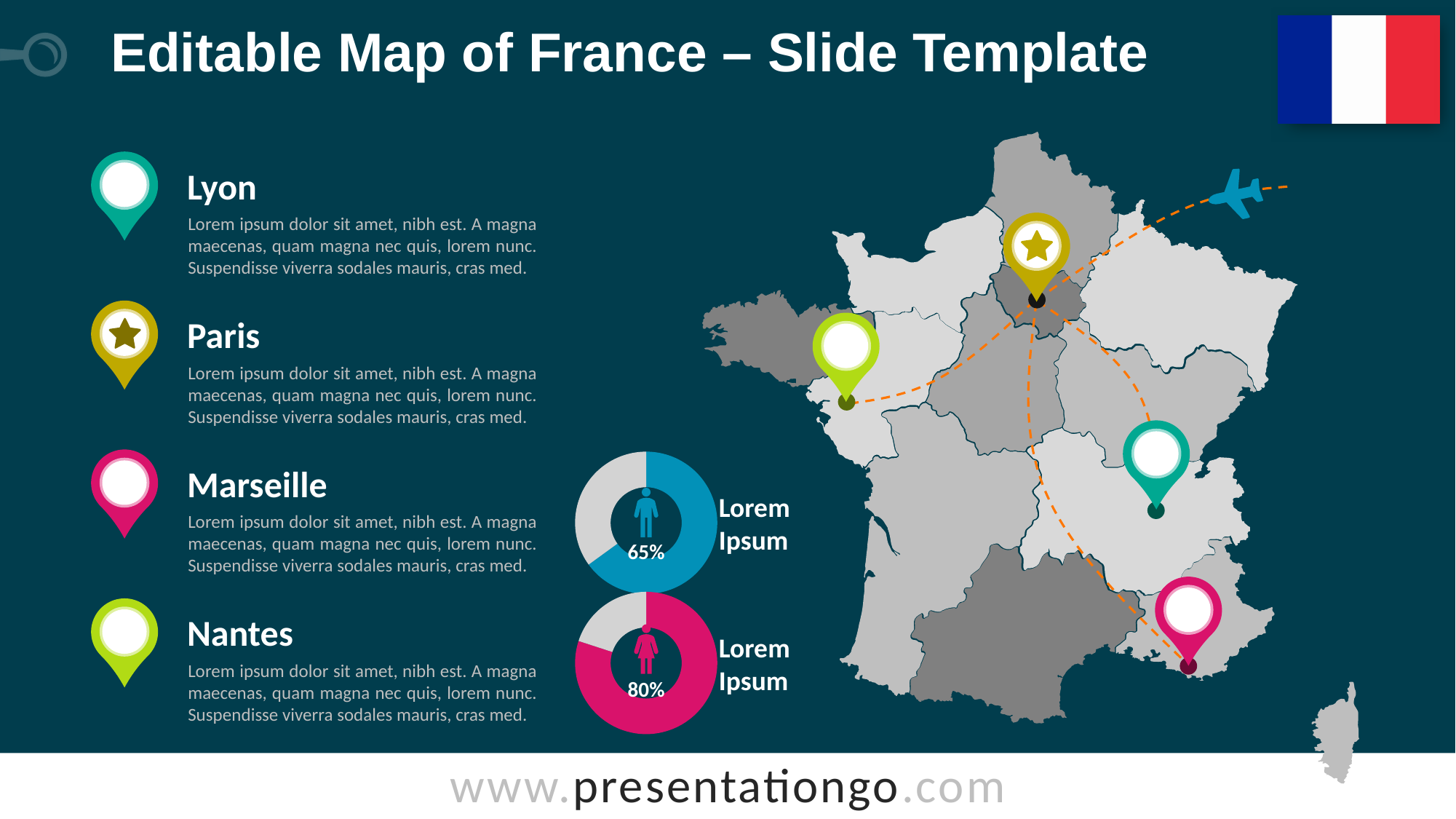
What kind of charts are the two circular charts next to the map? donut charts Is the value in the blue donut chart greater or less than 50%? greater What is the difference in percentage points between the pink donut chart's value and the blue donut chart's value? 15 What label text appears to the right of each donut chart? Lorem Ipsum Which donut chart shows the smaller value, the upper one or the lower one? the upper one How many donut charts are shown on the slide? 2 What value is shown in the upper donut chart with the blue segment? 65% What colour is the filled segment of the donut chart showing 65%? blue What value is shown in the lower donut chart with the pink segment? 80% Is the value in the pink donut chart greater or less than 75%? greater Which of the two donut charts shows the larger percentage, the blue one or the pink one? the pink one